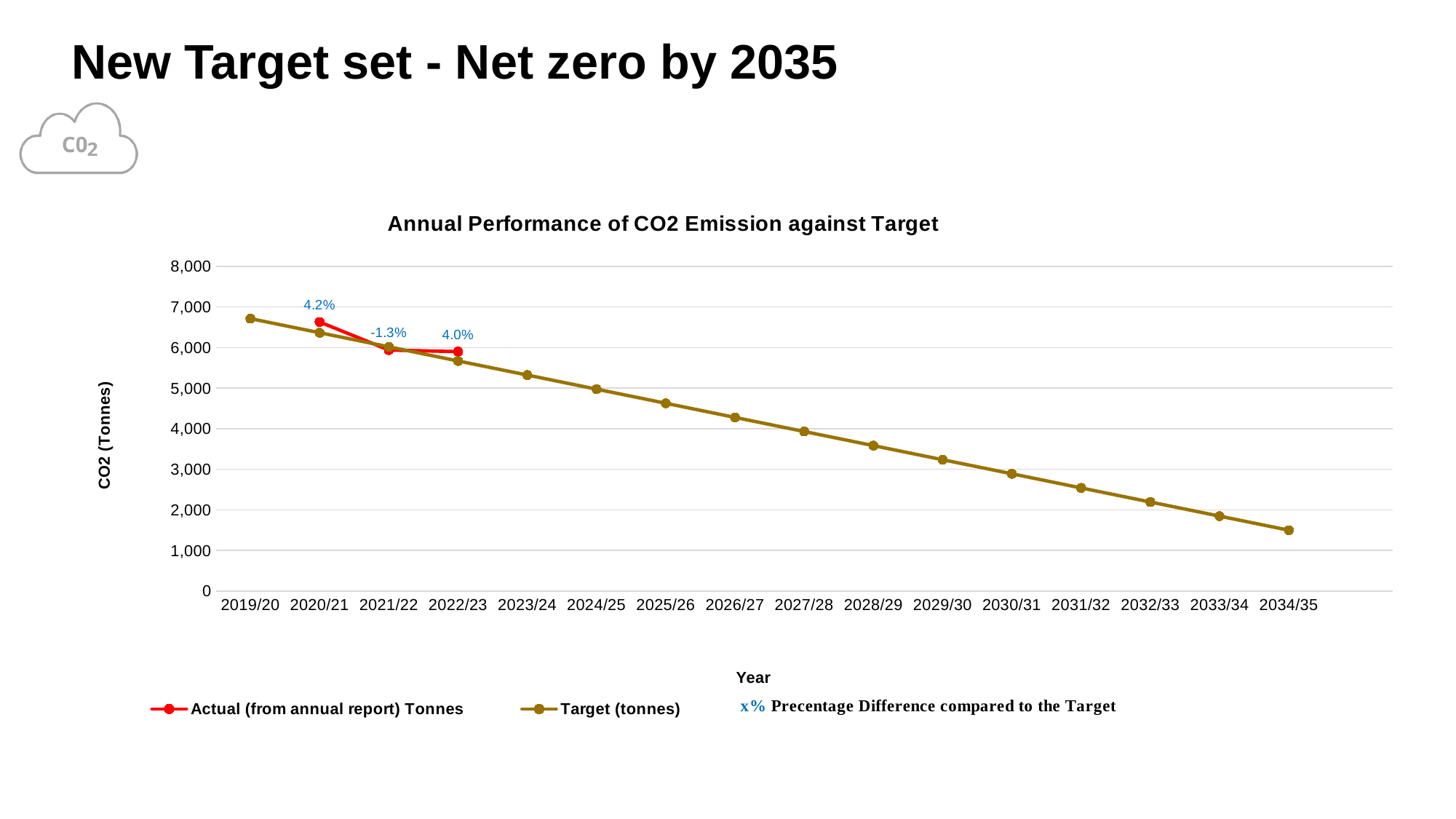
Does the Target (tonnes) series rise or fall from 2019/20 to 2034/35? fall In which year is the Target (tonnes) value lowest? 2034/35 Is the Target (tonnes) value for 2019/20 greater or less than 6,000? greater What is the percentage difference compared to the target shown for 2021/22? -1.3% In which year is the Target (tonnes) value highest? 2019/20 What is the percentage difference compared to the target shown for 2022/23? 4.0% How many series does the chart legend list? 2 What kind of chart is shown on the slide? line chart What is the title of the chart? Annual Performance of CO2 Emission against Target What is the percentage difference compared to the target shown for 2020/21? 4.2% How many years are shown on the x axis of the chart? 16 Is the Target (tonnes) value for 2034/35 greater or less than 2,000? less